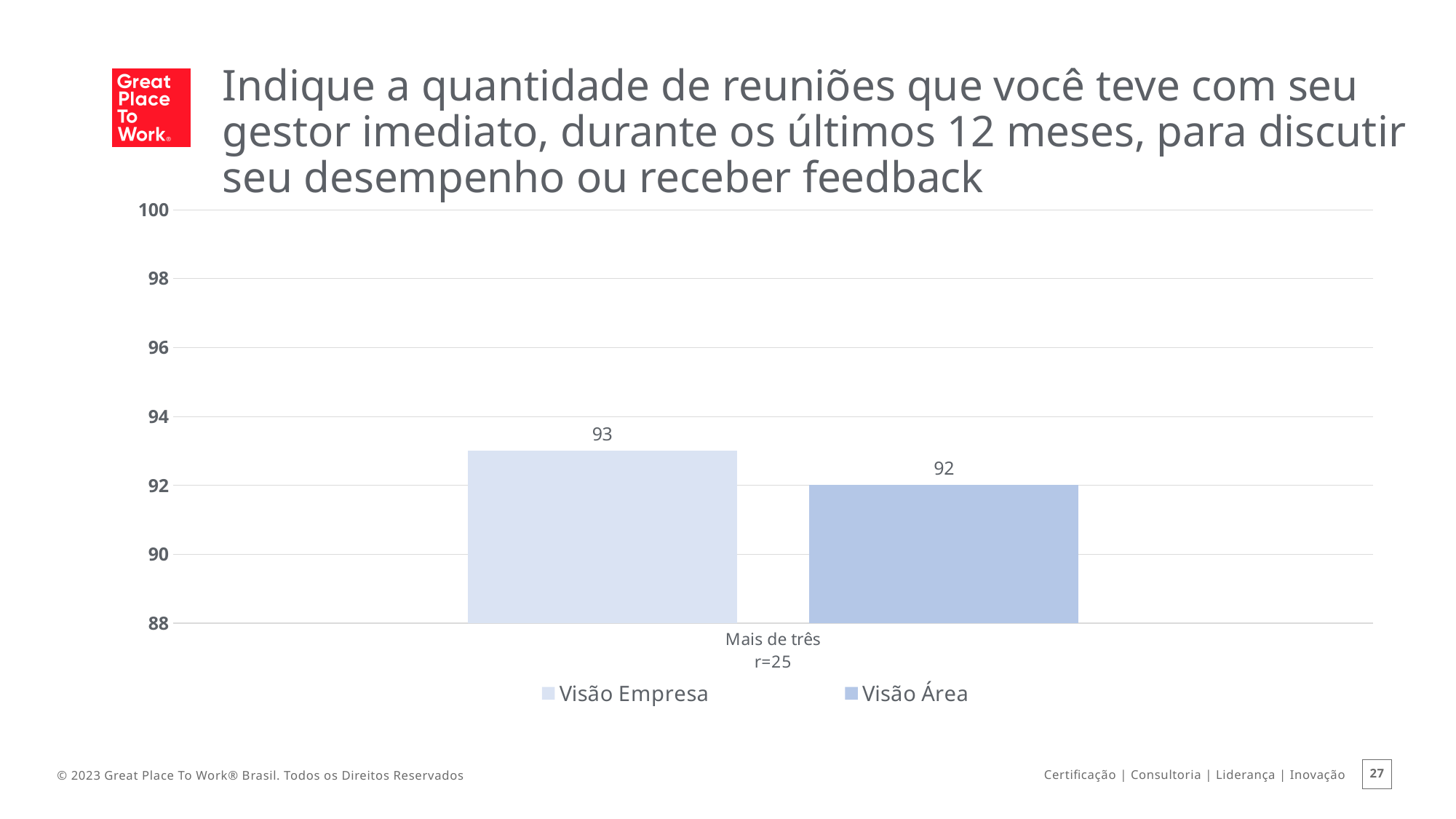
What is the value for Visão Área in the 'Mais de três' category? 92 Which series has the higher value for 'Mais de três', Visão Empresa or Visão Área? Visão Empresa What kind of chart is shown on the slide? Bar chart What is the r value shown under the category label? r=25 Is the value for Visão Área greater or less than 90? greater What is the difference between the Visão Empresa and Visão Área values? 1 What is the lowest value shown on the y axis? 88 Is the value for Visão Empresa greater or less than 94? less What is the label of the category on the x axis? Mais de três How many categories are shown on the x axis? 1 How many series does the legend list? 2 What is the value for Visão Empresa in the 'Mais de três' category? 93